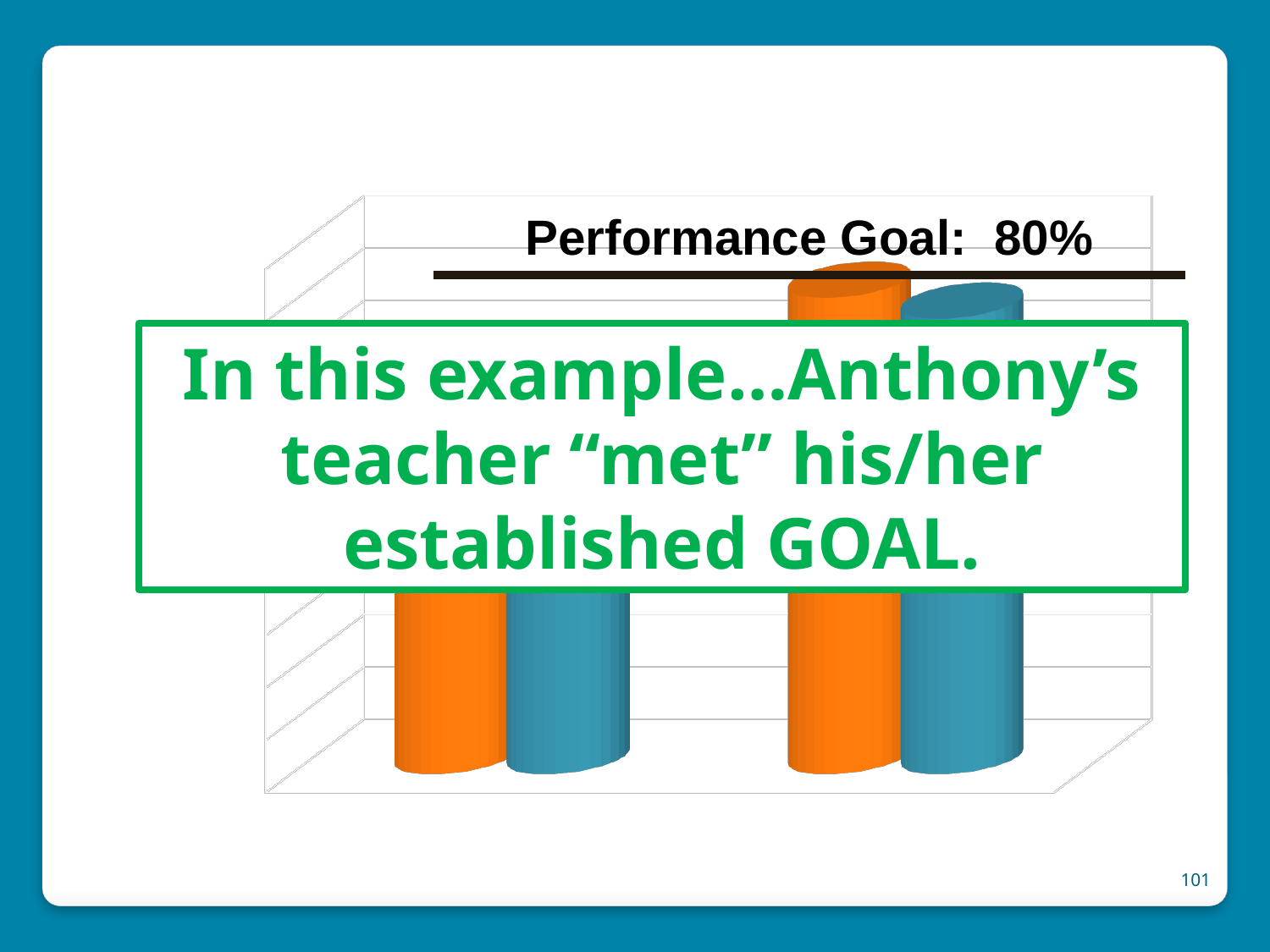
What performance goal value is labelled on the horizontal reference line? 80% How many bars in total are plotted on the chart? 4 How many groups of bars are plotted on the chart? 2 What kind of chart is shown on the slide? bar chart Which group of bars is taller, the left group or the right group? the right group What two colours are used for the bars on the chart? orange and blue